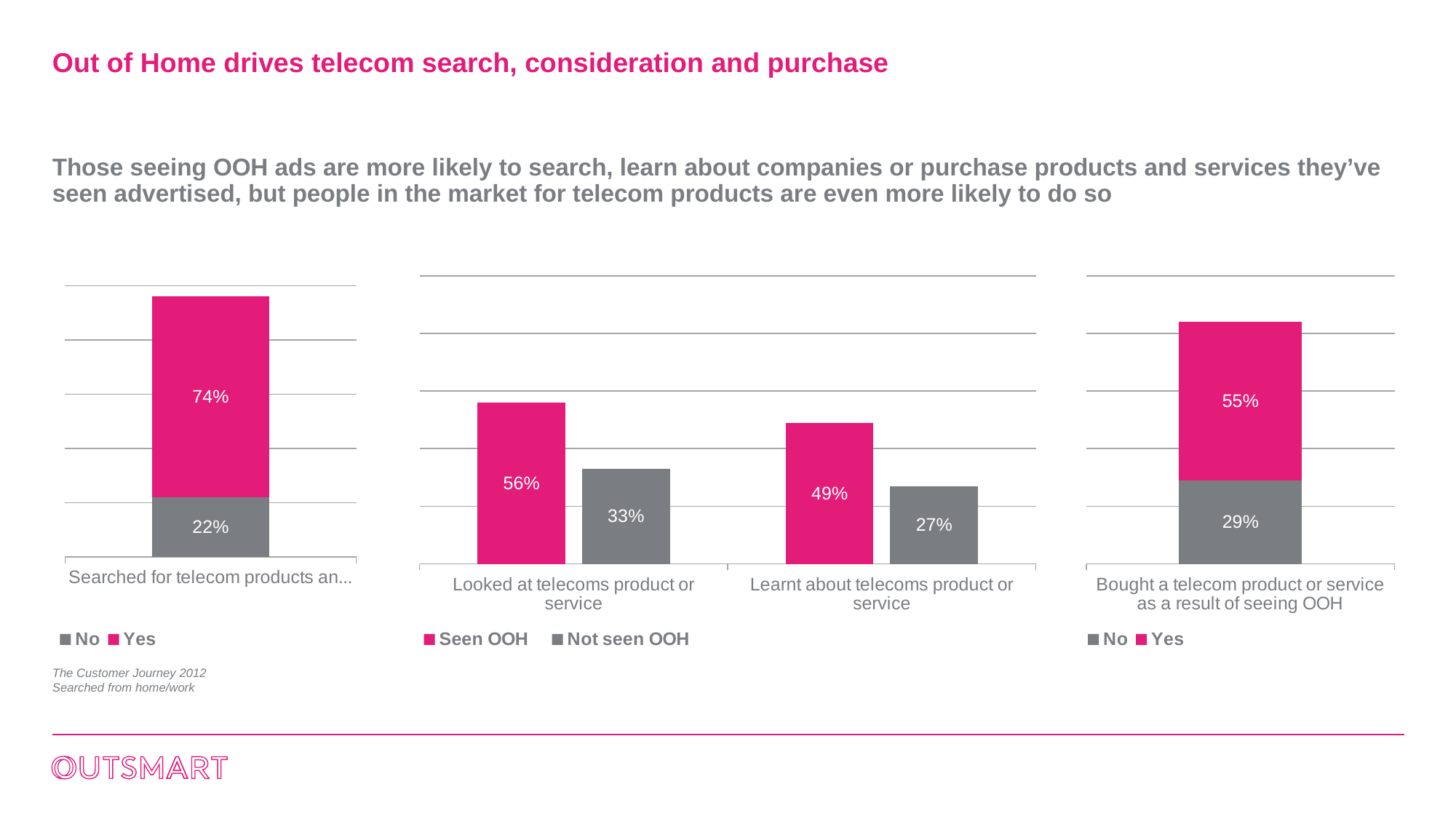
In the right chart, what is the total of the stacked bar (No plus Yes)? 84% In the middle chart, which colour represents Seen OOH? Pink In the left chart, what is the value for Yes? 74% In the middle chart, what is the difference between Seen OOH and Not seen OOH for 'Looked at telecoms product or service'? 23% In the middle chart, how many categories are shown on the x axis? 2 In the middle chart, what is the Not seen OOH value for 'Learnt about telecoms product or service'? 27% In the middle chart, which is larger for 'Learnt about telecoms product or service': Seen OOH or Not seen OOH? Seen OOH In the left chart, what is the value for No? 22% How many series does the legend of the middle chart list? 2 What kind of chart is the middle chart? Bar chart In the middle chart, what is the Seen OOH value for 'Looked at telecoms product or service'? 56% In the right chart, what is the value for Yes? 55%